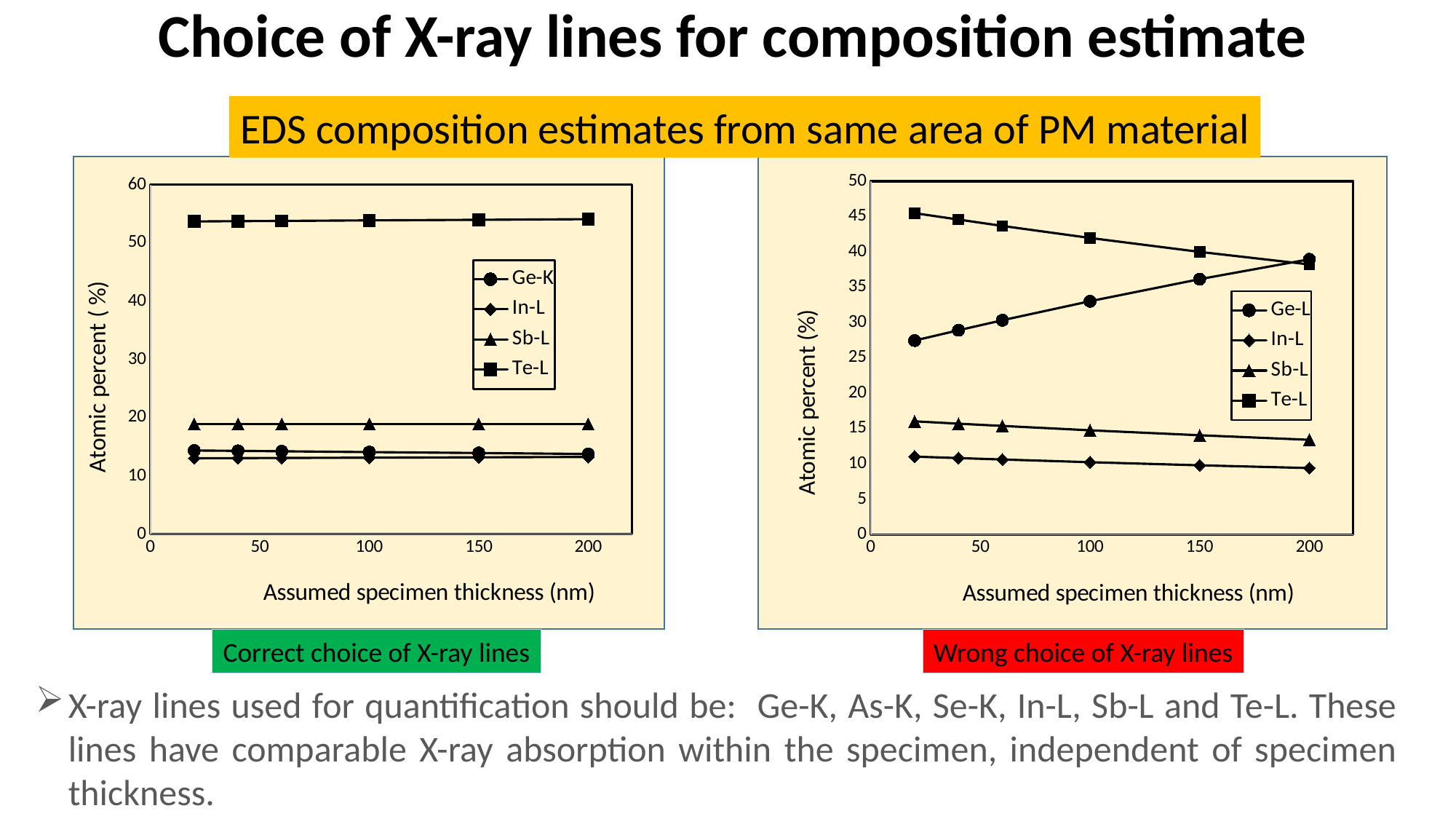
In the right chart ('Wrong choice of X-ray lines'), which is larger at 100 nm, Te-L or Ge-L? Te-L In the left chart ('Correct choice of X-ray lines'), is the Te-L value at 100 nm greater or less than 50? greater In the right chart ('Wrong choice of X-ray lines'), does the Ge-L series rise or fall as assumed specimen thickness increases? rise In the right chart ('Wrong choice of X-ray lines'), is the Te-L value at 20 nm greater or less than 40? greater How many data points does each series have in the left chart ('Correct choice of X-ray lines')? 6 What type of chart is the left chart labelled 'Correct choice of X-ray lines'? line chart How many series does the legend of the right chart ('Wrong choice of X-ray lines') list? 4 In the right chart ('Wrong choice of X-ray lines'), which series has the lowest atomic percent? In-L In the left chart ('Correct choice of X-ray lines'), which series has the highest atomic percent? Te-L In the right chart ('Wrong choice of X-ray lines'), does the Te-L series rise or fall as assumed specimen thickness increases? fall In the right chart ('Wrong choice of X-ray lines'), is the Ge-L value at 20 nm greater or less than 30? less